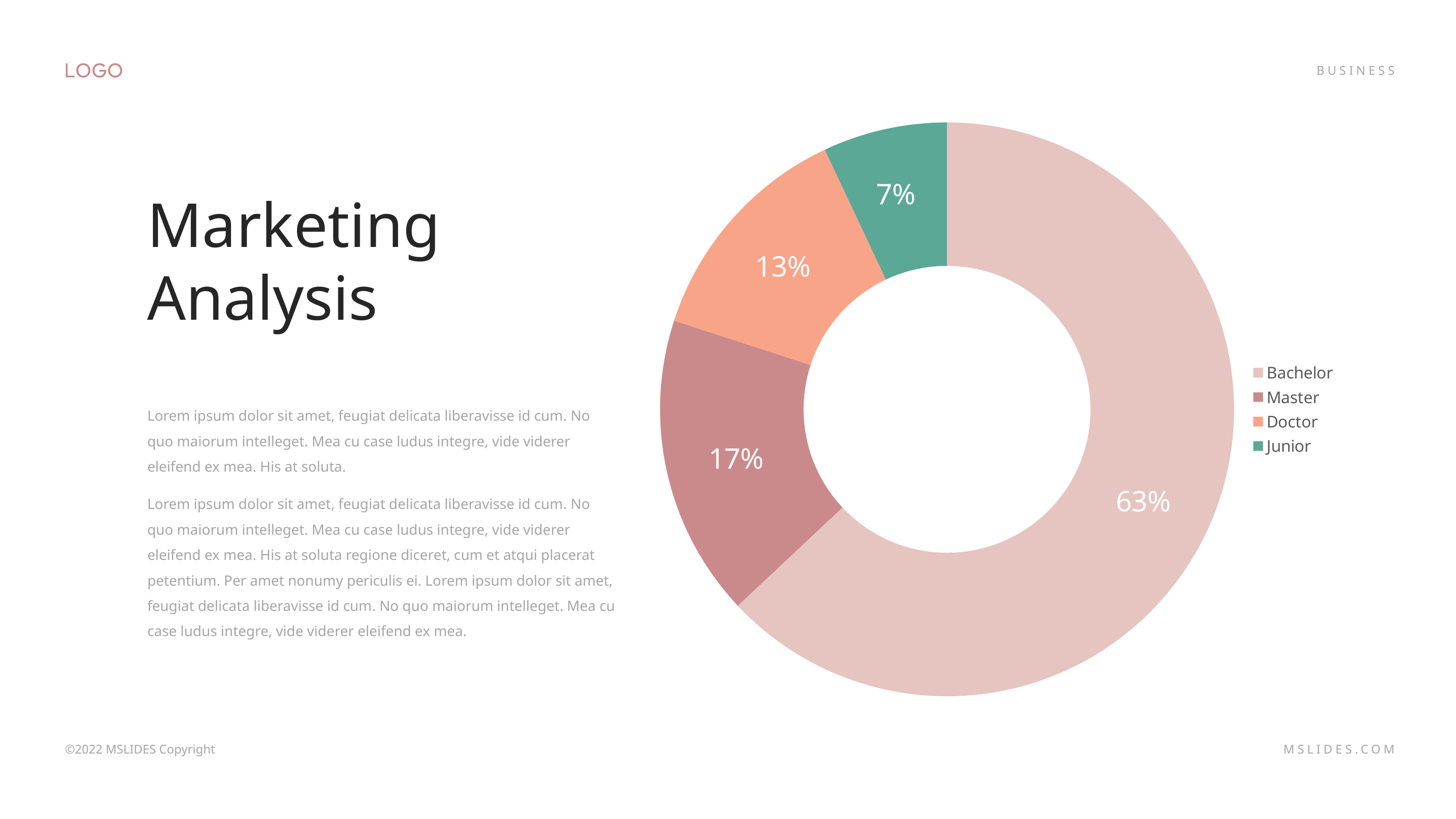
What is the difference in percentage points between the Doctor and Junior slices? 6 What is the difference in percentage points between the Bachelor and Master slices? 46 What percentage does the Doctor slice show? 13% What kind of chart is shown on the slide? Doughnut (pie) chart Which category is shown in green in the legend? Junior Which category has the smallest share of the chart? Junior Which slice is larger, Master or Doctor? Master Which category has the largest share of the chart? Bachelor What percentage does the Bachelor slice show? 63% What percentage does the Master slice show? 17% How many categories does the chart show? 4 What percentage does the Junior slice show? 7%